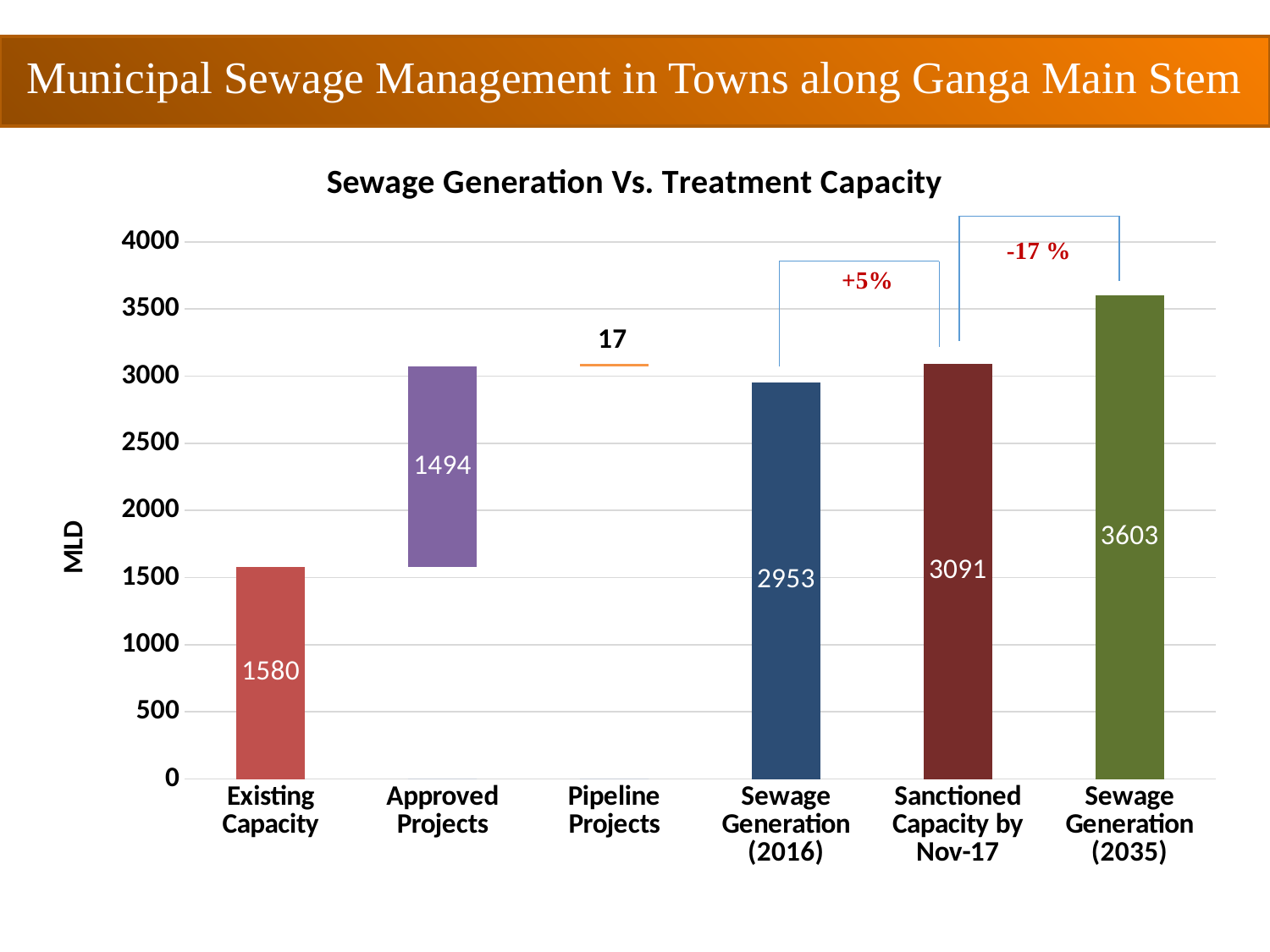
What is the value for Existing Capacity? 1580 What is the value for Approved Projects? 1494 What is the value for Pipeline Projects? 17 What is the value for Sewage Generation (2016)? 2953 What is the value for Sanctioned Capacity by Nov-17? 3091 How many categories are shown on the x axis? 6 What is the difference between Sewage Generation (2035) and Sanctioned Capacity by Nov-17? 512 Which category has the lowest value? Pipeline Projects What is the value for Sewage Generation (2035)? 3603 What is the title of the chart? Sewage Generation Vs. Treatment Capacity Which is larger, Sanctioned Capacity by Nov-17 or Sewage Generation (2016)? Sanctioned Capacity by Nov-17 Which category has the highest value? Sewage Generation (2035)